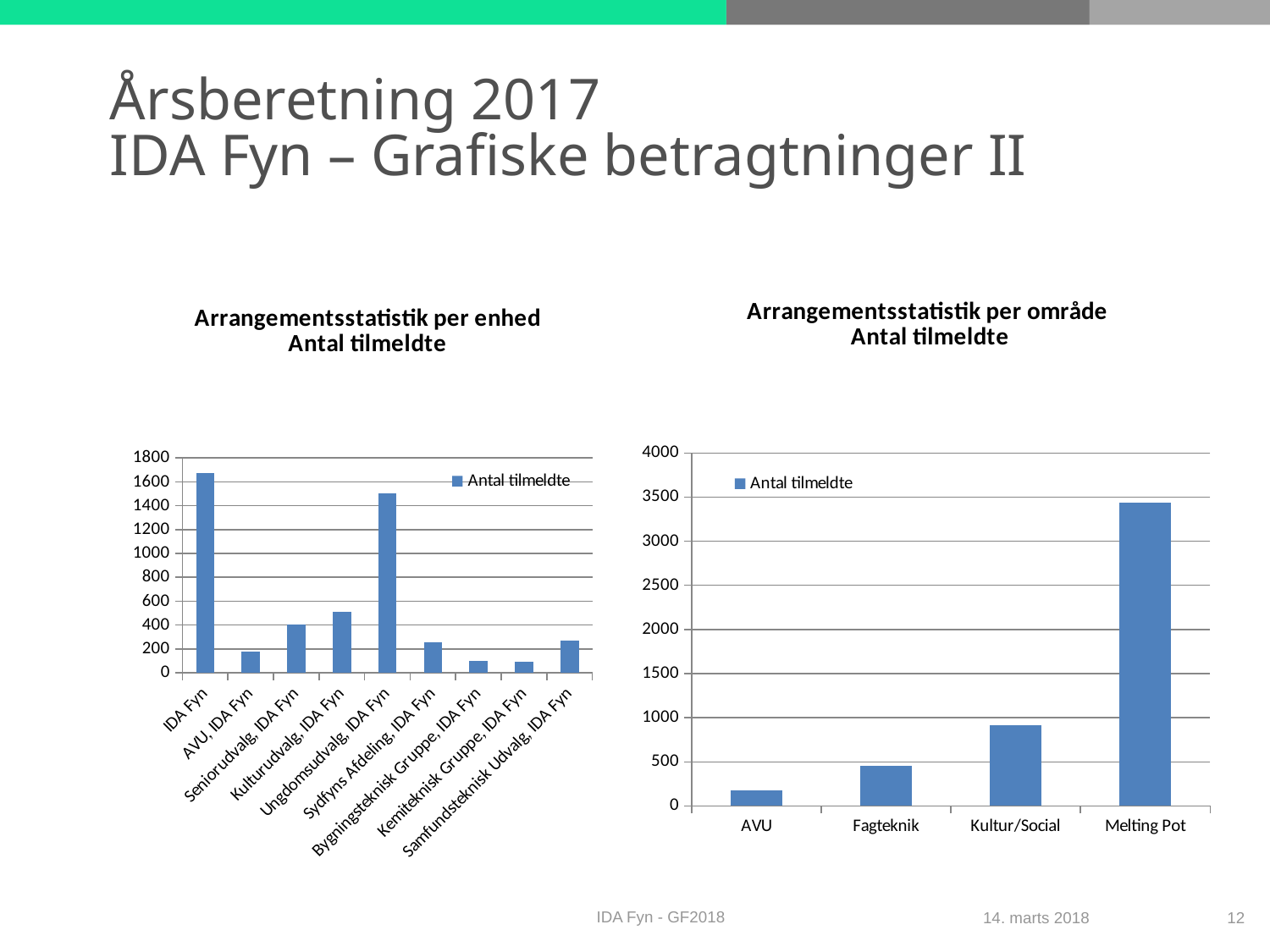
In the chart titled 'Arrangementsstatistik per område Antal tilmeldte', is the value for Melting Pot greater or less than 3000? greater In the chart titled 'Arrangementsstatistik per enhed Antal tilmeldte', is the value for Sydfyns Afdeling, IDA Fyn greater or less than 400? less In the chart titled 'Arrangementsstatistik per enhed Antal tilmeldte', is the value for Ungdomsudvalg, IDA Fyn greater or less than 1400? greater In the chart titled 'Arrangementsstatistik per område Antal tilmeldte', which category has the lowest number of Antal tilmeldte? AVU What kind of chart is the chart titled 'Arrangementsstatistik per enhed Antal tilmeldte'? bar chart In the chart titled 'Arrangementsstatistik per enhed Antal tilmeldte', which is larger, the value for Kulturudvalg, IDA Fyn or the value for Ungdomsudvalg, IDA Fyn? Ungdomsudvalg, IDA Fyn In the chart titled 'Arrangementsstatistik per område Antal tilmeldte', which category has the highest number of Antal tilmeldte? Melting Pot In the chart titled 'Arrangementsstatistik per område Antal tilmeldte', which is larger, the value for Fagteknik or the value for Kultur/Social? Kultur/Social How many categories are shown on the x axis of the chart titled 'Arrangementsstatistik per område Antal tilmeldte'? 4 How many series does the legend list in the chart titled 'Arrangementsstatistik per enhed Antal tilmeldte'? 1 In the chart titled 'Arrangementsstatistik per enhed Antal tilmeldte', which category has the highest number of Antal tilmeldte? IDA Fyn